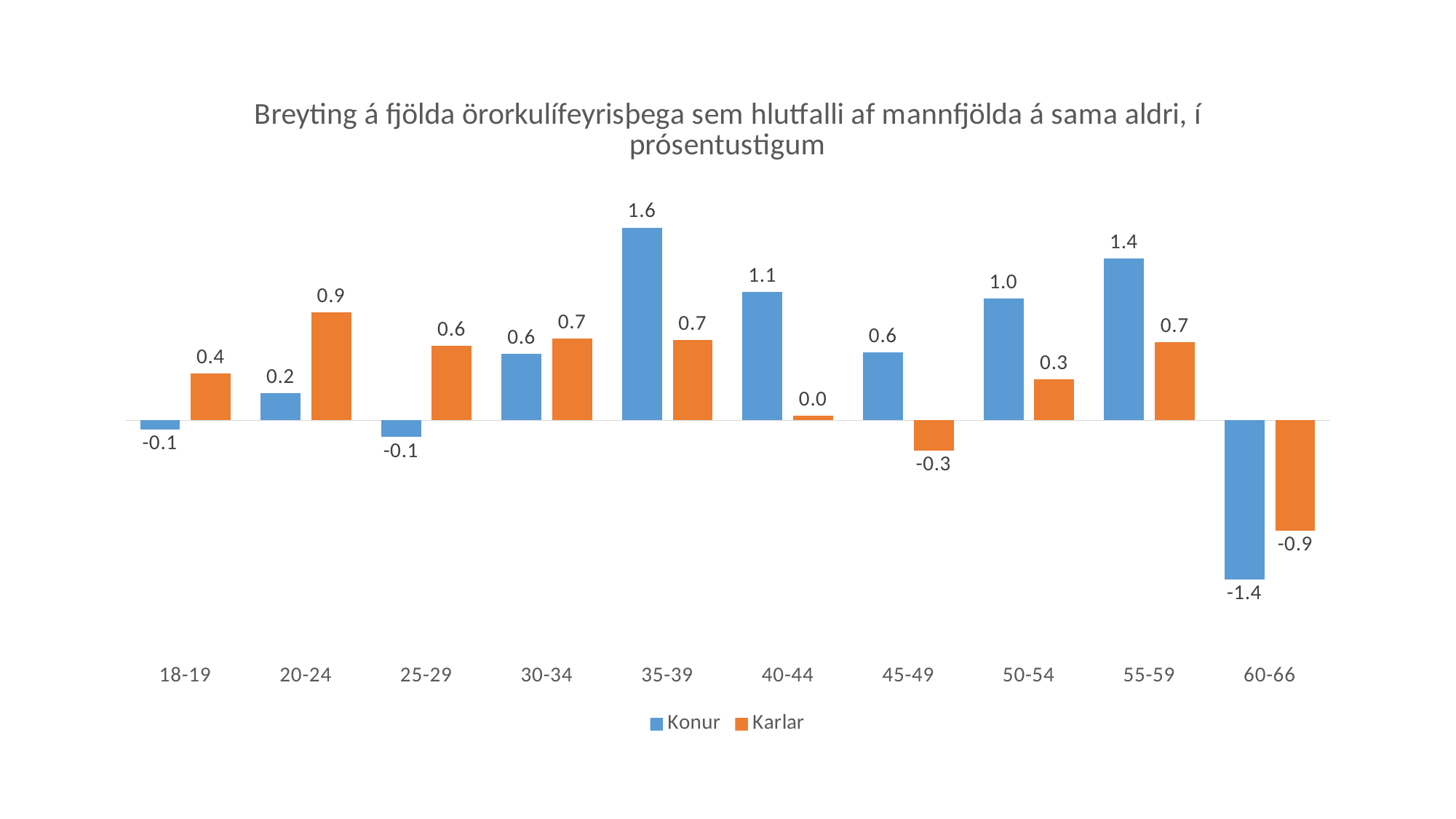
Which colour represents the Karlar series? Orange What is the value for Karlar in the 20-24 age group? 0.9 What kind of chart is shown on the slide? Bar chart Which age group has the highest value for Konur? 35-39 What is the value for Karlar in the 40-44 age group? 0.0 What is the difference between the Konur and Karlar values in the 55-59 age group? 0.7 How many age groups are shown on the x axis? 10 What is the value for Konur in the 35-39 age group? 1.6 How many series does the legend list? 2 In the 20-24 age group, which series has the larger value, Konur or Karlar? Karlar Which age group has the lowest value for Karlar? 60-66 What is the value for Konur in the 60-66 age group? -1.4